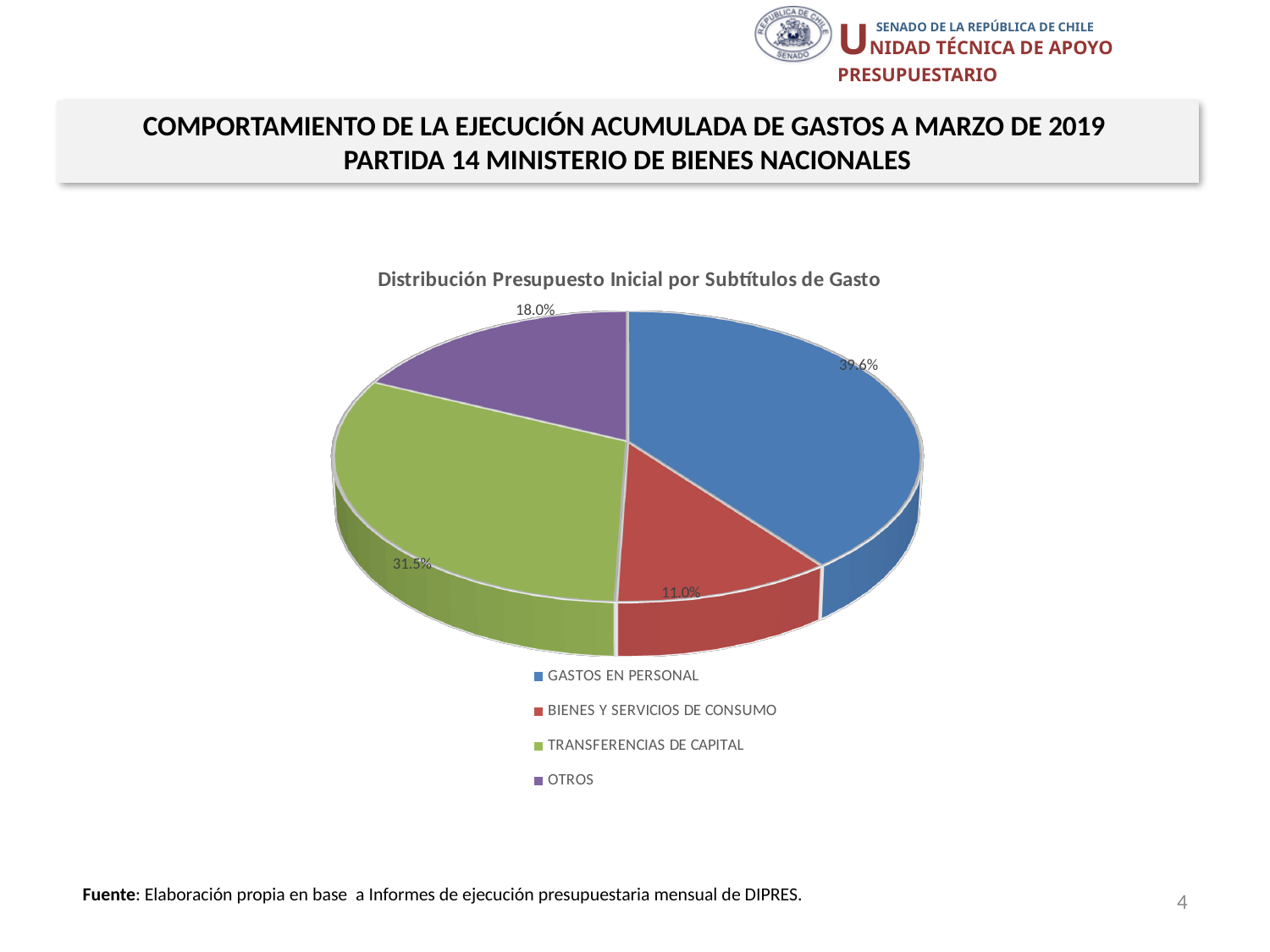
What share of the pie does BIENES Y SERVICIOS DE CONSUMO represent? 11.0% Which is larger, the share for OTROS or the share for BIENES Y SERVICIOS DE CONSUMO? OTROS How many categories does the pie chart show? 4 What is the title of the chart? Distribución Presupuesto Inicial por Subtítulos de Gasto What share of the pie does GASTOS EN PERSONAL represent? 39.6% What share of the pie does TRANSFERENCIAS DE CAPITAL represent? 31.5% What kind of chart is shown on the slide? Pie chart Which category has the largest slice of the pie? GASTOS EN PERSONAL What is the difference in percentage points between GASTOS EN PERSONAL and TRANSFERENCIAS DE CAPITAL? 8.1 Which category has the smallest slice of the pie? BIENES Y SERVICIOS DE CONSUMO Which colour represents TRANSFERENCIAS DE CAPITAL in the chart? Green